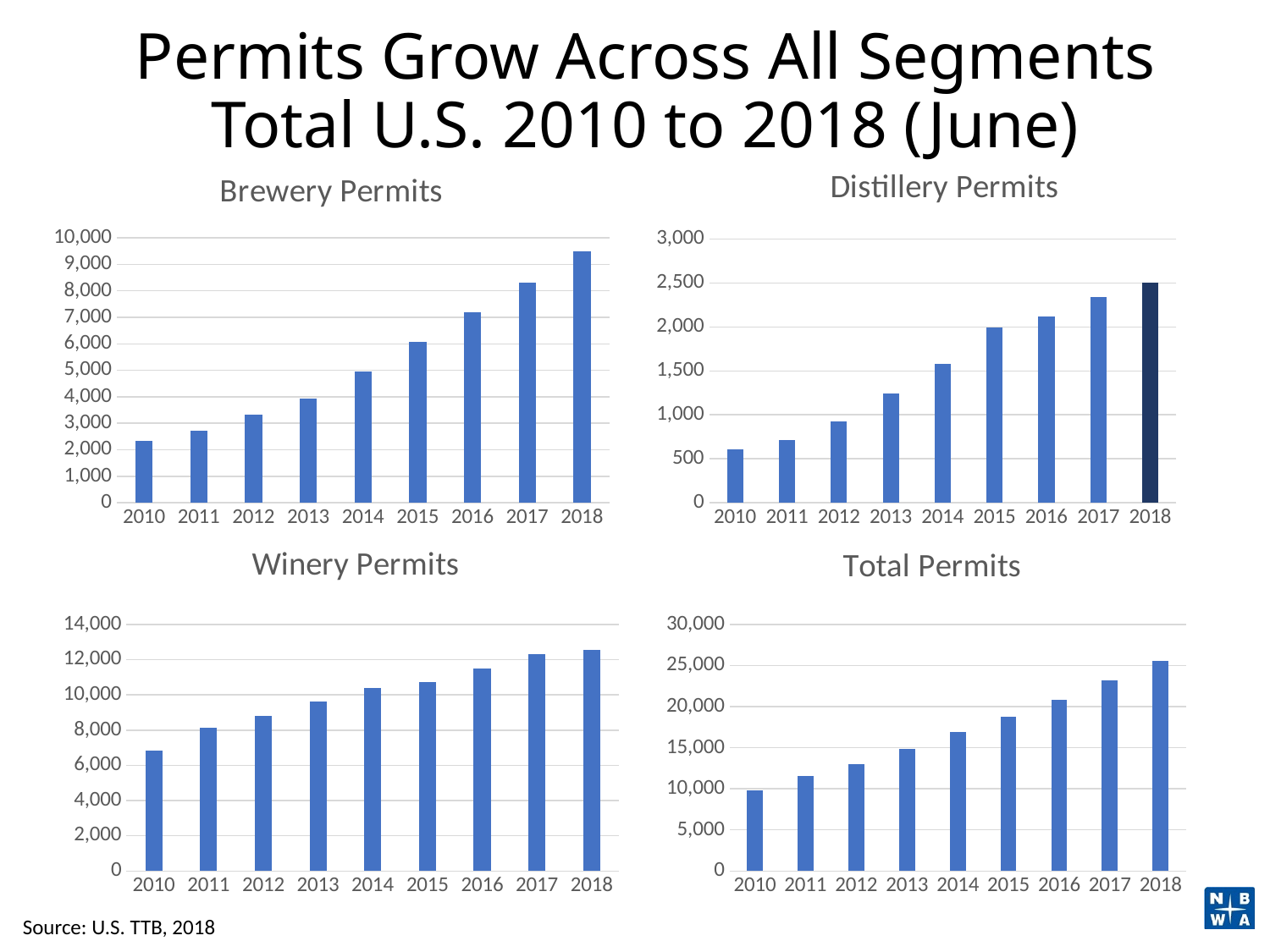
In the Brewery Permits chart, which year has the highest value? 2018 In the Distillery Permits chart, which year's bar is shown in a darker colour than the others? 2018 In the Distillery Permits chart, is the value for 2010 greater or less than 1,000? less In the Total Permits chart, do the values rise or fall from 2010 to 2018? rise In the Winery Permits chart, is the value for 2010 greater or less than 8,000? less In the Brewery Permits chart, is the value for 2018 greater or less than 9,000? greater How many years are shown on the x axis of the Distillery Permits chart? 9 What kind of chart is the Brewery Permits chart? bar chart In the Winery Permits chart, which is larger, the value for 2012 or the value for 2016? 2016 In the Brewery Permits chart, which year has the lowest value? 2010